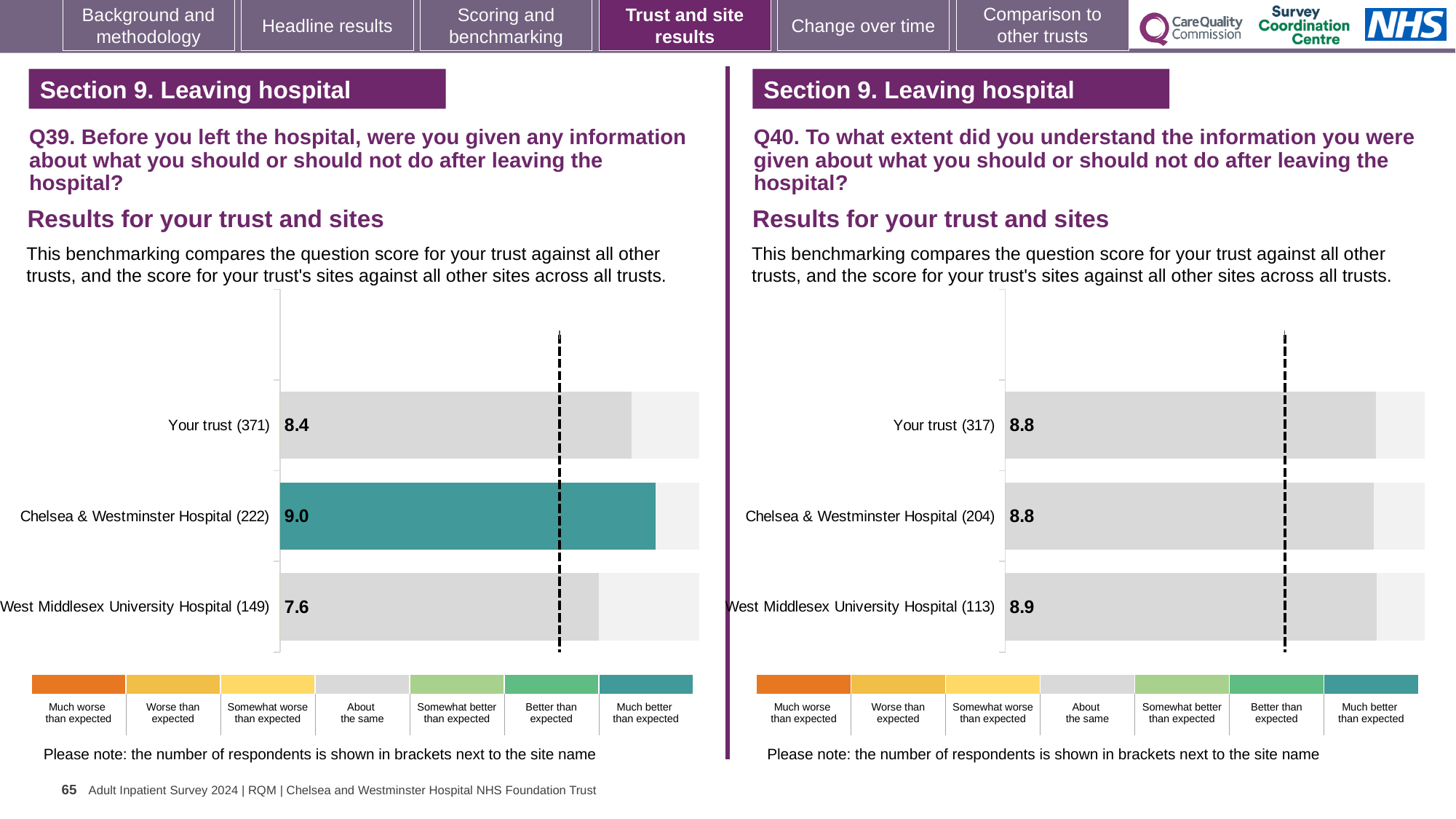
In the Q40 chart on the right, what is the score for West Middlesex University Hospital? 8.9 In the Q40 chart on the right, what is the score for Your trust? 8.8 In the Q39 chart on the left, which site or trust has the lowest score? West Middlesex University Hospital How many bars are plotted in the Q39 chart on the left? 3 In the Q39 chart on the left, what is the score for Your trust? 8.4 In the Q39 chart on the left, what is the difference between the scores for Chelsea & Westminster Hospital and West Middlesex University Hospital? 1.4 In the Q40 chart on the right, how many respondents are shown for Chelsea & Westminster Hospital? 204 In the Q39 chart on the left, what is the score for Chelsea & Westminster Hospital? 9.0 What type of chart is used in the Q40 chart on the right? Bar chart In the Q39 chart on the left, which site or trust has the highest score? Chelsea & Westminster Hospital In the Q39 chart on the left, what is the score for West Middlesex University Hospital? 7.6 In the Q39 chart on the left, which benchmark category does the colour of the Chelsea & Westminster Hospital bar correspond to in the legend? Much better than expected